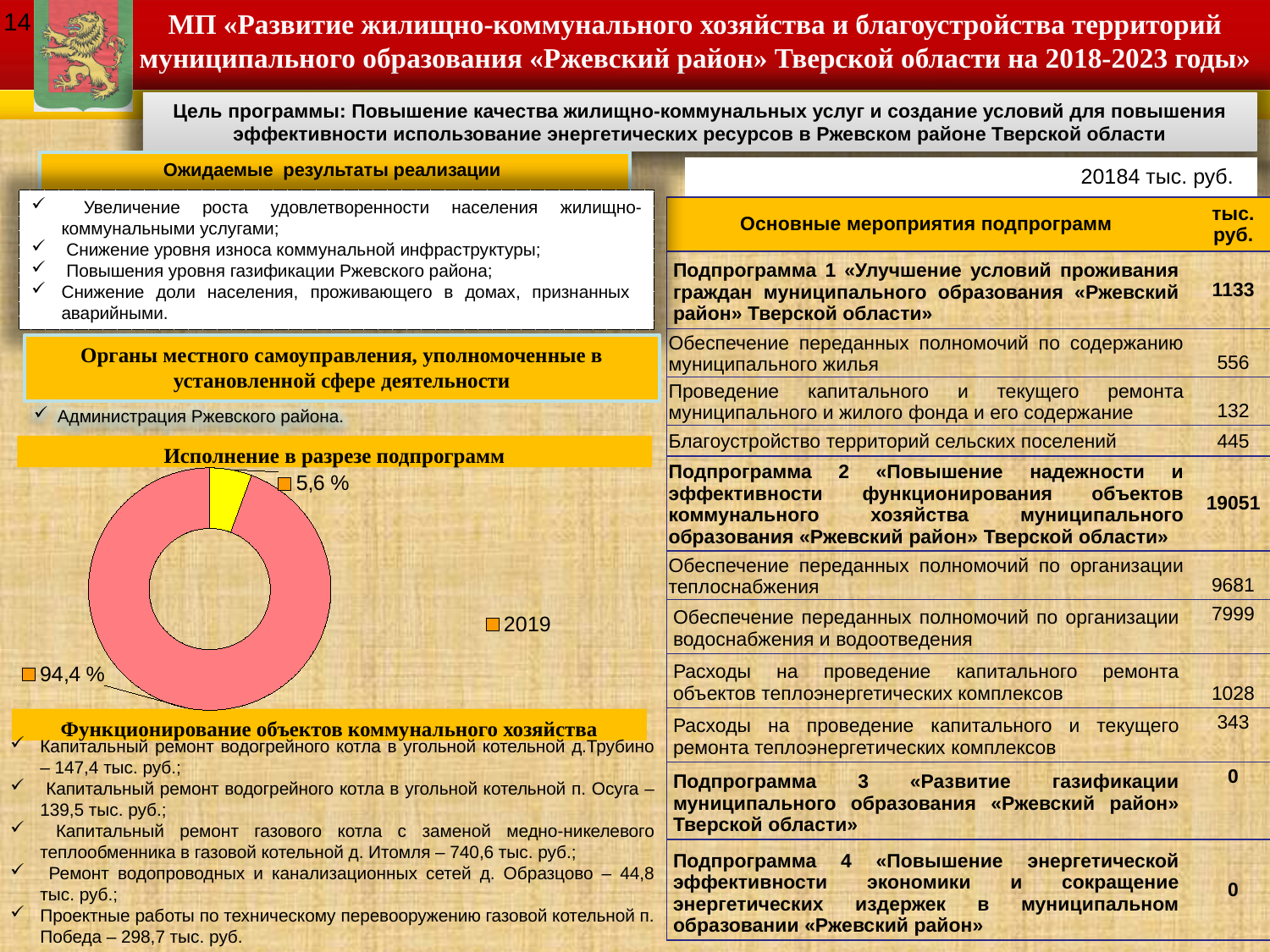
Which year is labelled next to the pie chart «Исполнение в разрезе подпрограмм»? 2019 What is the value of the larger (pink) slice in the chart «Исполнение в разрезе подпрограмм»? 94,4 % Which slice of the chart «Исполнение в разрезе подпрограмм» is the smallest? the yellow slice, 5,6 % In the chart «Исполнение в разрезе подпрограмм», what is the difference between the two slice values? 88,8 % Which slice of the chart «Исполнение в разрезе подпрограмм» is the largest? the pink slice, 94,4 % What is the value of the smaller (yellow) slice in the chart «Исполнение в разрезе подпрограмм»? 5,6 % How many slices does the chart «Исполнение в разрезе подпрограмм» have? 2 What kind of chart is shown under the heading «Исполнение в разрезе подпрограмм»? pie chart (doughnut) In the chart «Исполнение в разрезе подпрограмм», which slice is larger, the pink one or the yellow one? the pink one What is the title of the pie chart on the slide? Исполнение в разрезе подпрограмм What share of the chart «Исполнение в разрезе подпрограмм» does the yellow slice represent? 5,6 %